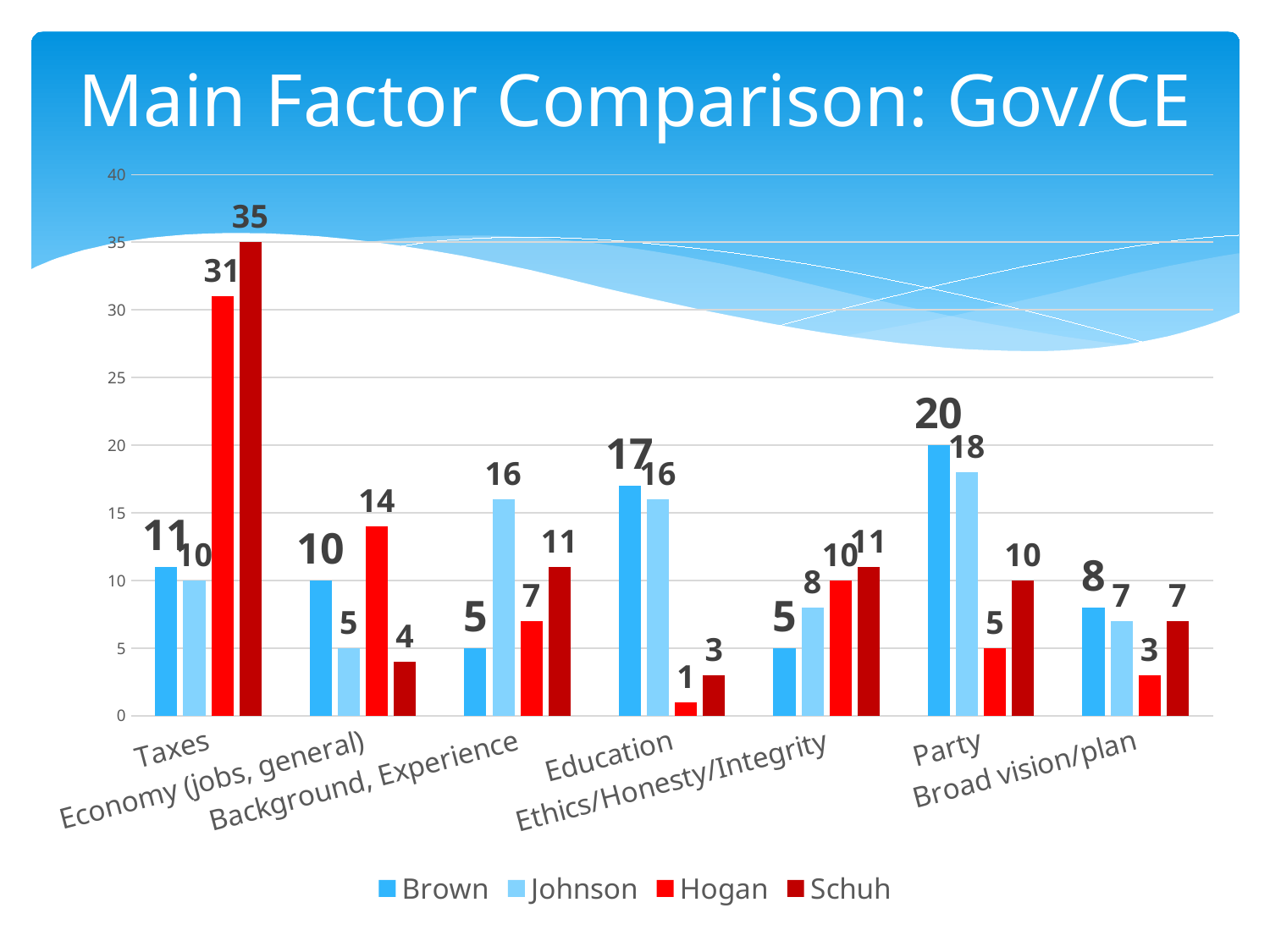
How many categories are shown on the x axis? 7 What kind of chart is shown on the slide? Bar chart What is the value for Brown in the Party category? 20 What is the value for Johnson in the Background, Experience category? 16 What is the value for Hogan in the Education category? 1 Which category has the highest value for Hogan? Taxes What is the title of the chart? Main Factor Comparison: Gov/CE In the Economy (jobs, general) category, which is larger: Brown's value or Hogan's value? Hogan How many series does the legend list? 4 What is the value for Schuh in the Taxes category? 35 What is the difference between Schuh's and Hogan's values in the Taxes category? 4 Which category has the lowest value for Schuh? Education